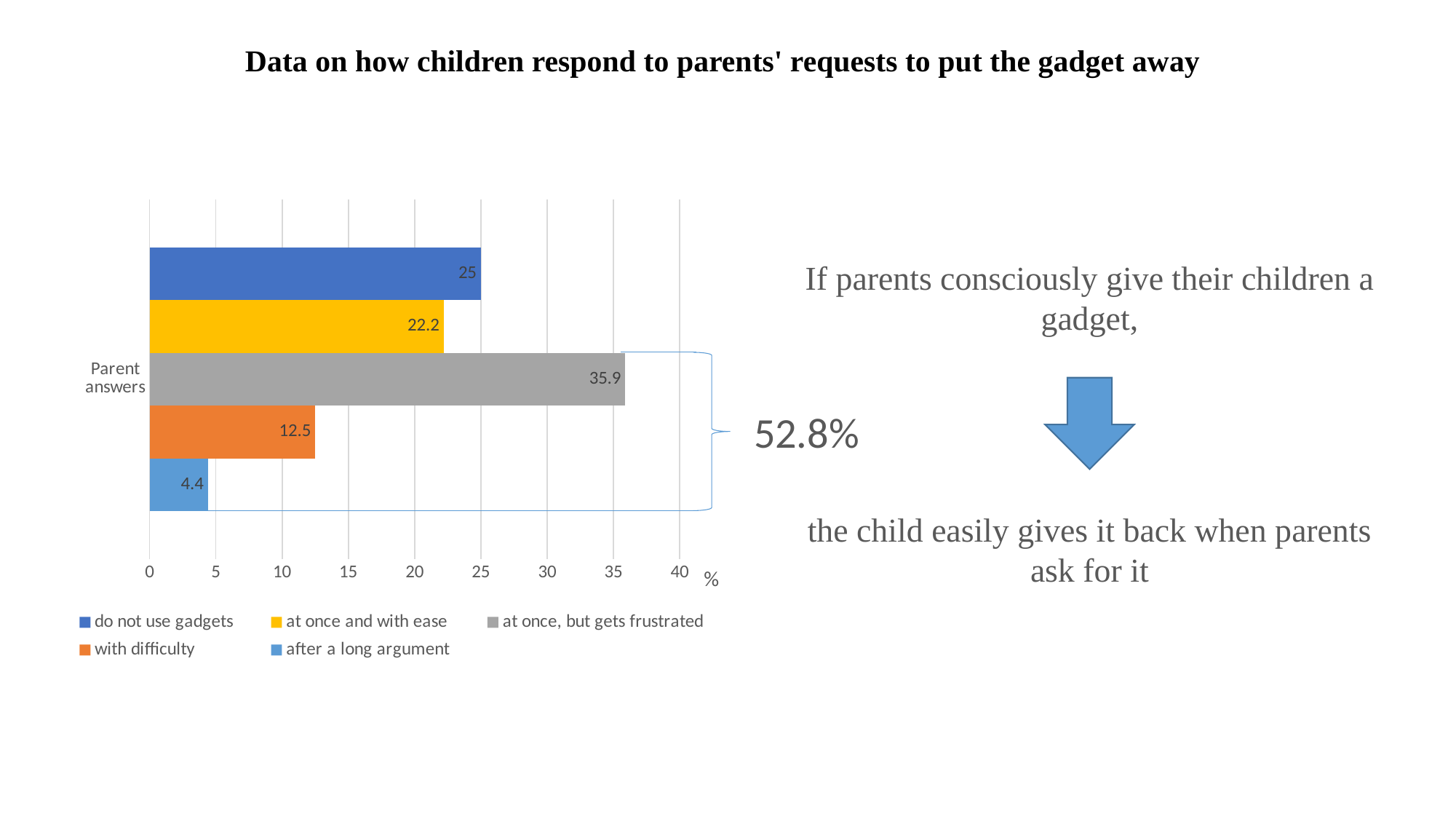
What unit is shown on the horizontal axis? % What kind of chart is shown on the slide? bar chart Which series has the lowest value? after a long argument What is the title of the chart? Data on how children respond to parents' requests to put the gadget away Which series has the highest value? at once, but gets frustrated What is the value for "with difficulty"? 12.5 Which is larger, the value for "do not use gadgets" or the value for "with difficulty"? do not use gadgets What is the value for "at once, but gets frustrated"? 35.9 How many series does the legend list? 5 What is the difference between the values for "at once, but gets frustrated" and "at once and with ease"? 13.7 What is the value for "do not use gadgets"? 25 What is the value for "after a long argument"? 4.4